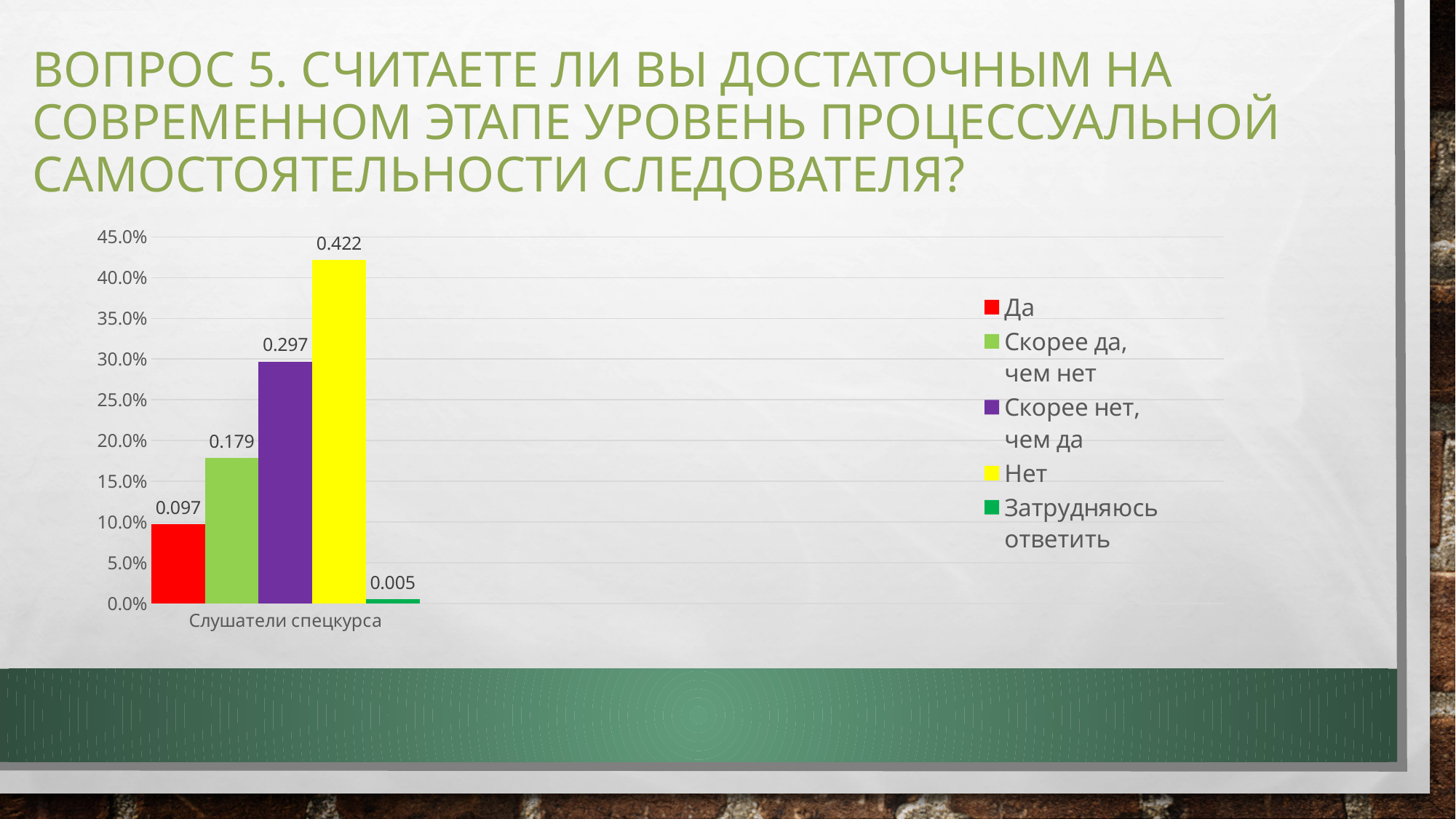
Which response option has the highest value? Нет What is the value for "Нет" among Слушатели спецкурса? 0.422 Is the value for "Скорее нет, чем да" greater or less than 25.0%? greater Which is larger, the value for "Скорее да, чем нет" or the value for "Да"? Скорее да, чем нет Which response option has the lowest value? Затрудняюсь ответить What is the value for "Скорее да, чем нет"? 0.179 What colour is the bar for "Нет"? yellow What is the value for "Да" among Слушатели спецкурса? 0.097 What kind of chart is shown on the slide? bar chart What is the difference between the values for "Нет" and "Скорее нет, чем да"? 0.125 What is the value for "Затрудняюсь ответить"? 0.005 How many series does the legend list? 5